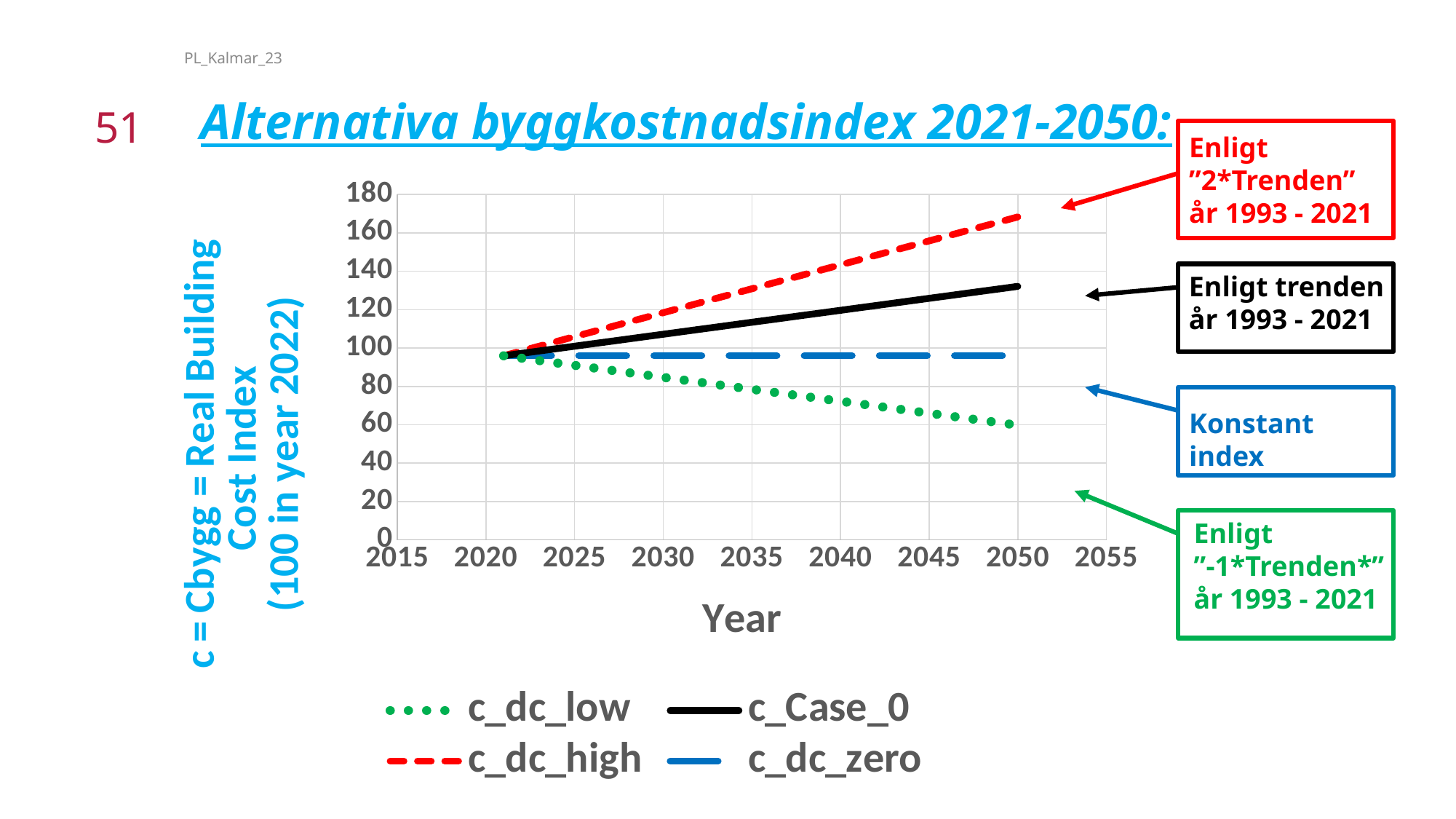
Is the value of c_Case_0 in 2050 greater or less than 120? greater Does the c_dc_high series rise or fall from 2021 to 2050? rise Is the value of c_dc_low in 2050 greater or less than 80? less Which series is drawn as a green dotted line? c_dc_low What is the label of the x axis? Year Which series has the lowest value in 2050? c_dc_low Does the c_dc_low series rise or fall from 2021 to 2050? fall Is the value of c_dc_high in 2050 greater or less than 160? greater What kind of chart is shown on the slide? line chart Which series has the highest value in 2050? c_dc_high How many series does the legend list? 4 In 2050, which is larger: c_Case_0 or c_dc_zero? c_Case_0